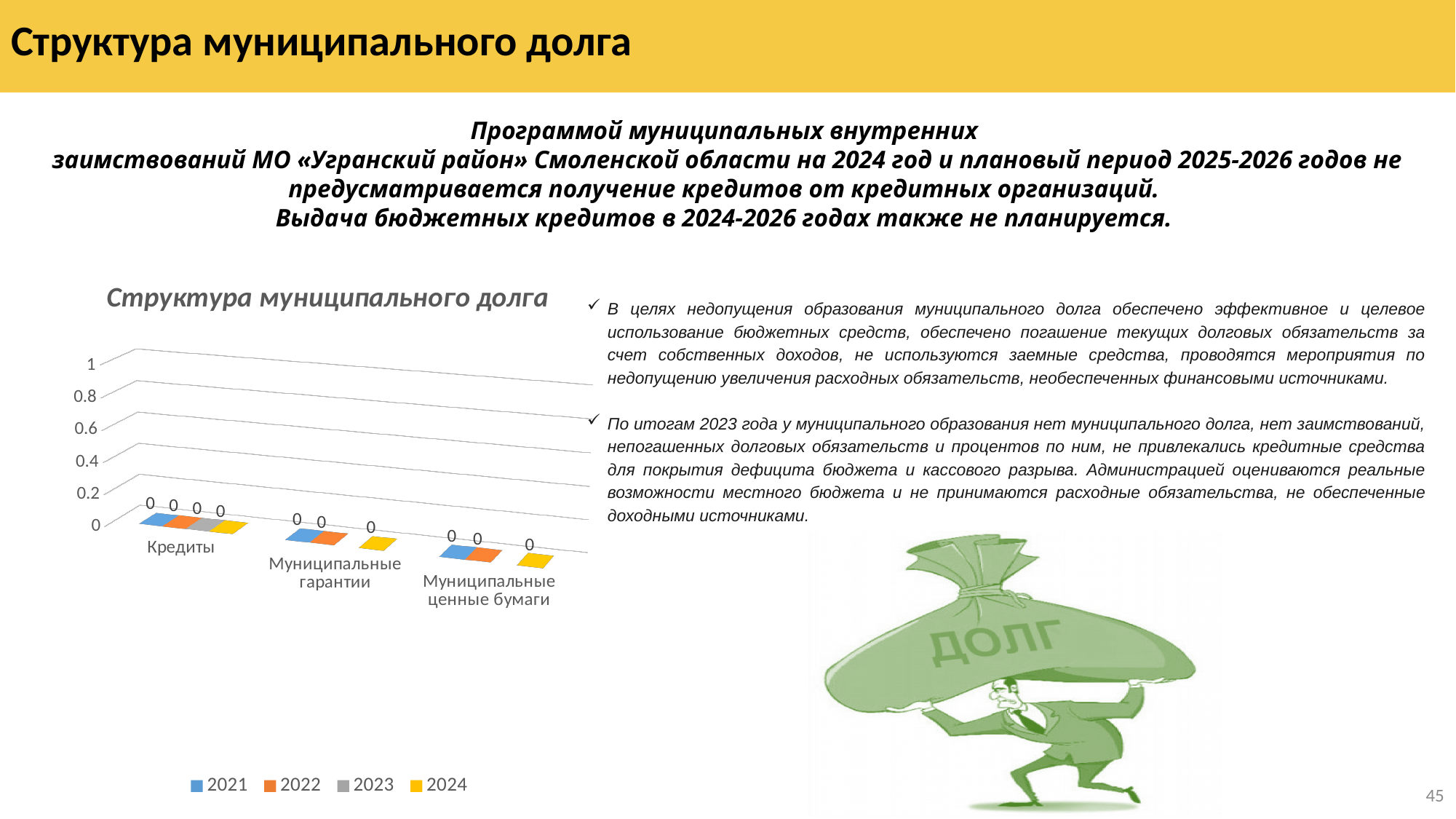
What is the value for Муниципальные гарантии in 2024? 0 How many categories are shown on the x axis of the chart? 3 Do the values for the 2024 series rise or fall across the categories from Кредиты to Муниципальные ценные бумаги? Neither, they stay at 0 What kind of chart is shown on the slide? Bar chart What is the difference between the 2024 value for Кредиты and the 2024 value for Муниципальные ценные бумаги? 0 What is the title of the chart? Структура муниципального долга Is the value for Муниципальные гарантии in 2022 greater or less than 0.2? less How many series does the chart legend list? 4 What is the value for Кредиты in 2023? 0 What is the value for Кредиты in 2021? 0 What is the value for Муниципальные ценные бумаги in 2022? 0 Which series is shown in yellow in the chart legend? 2024